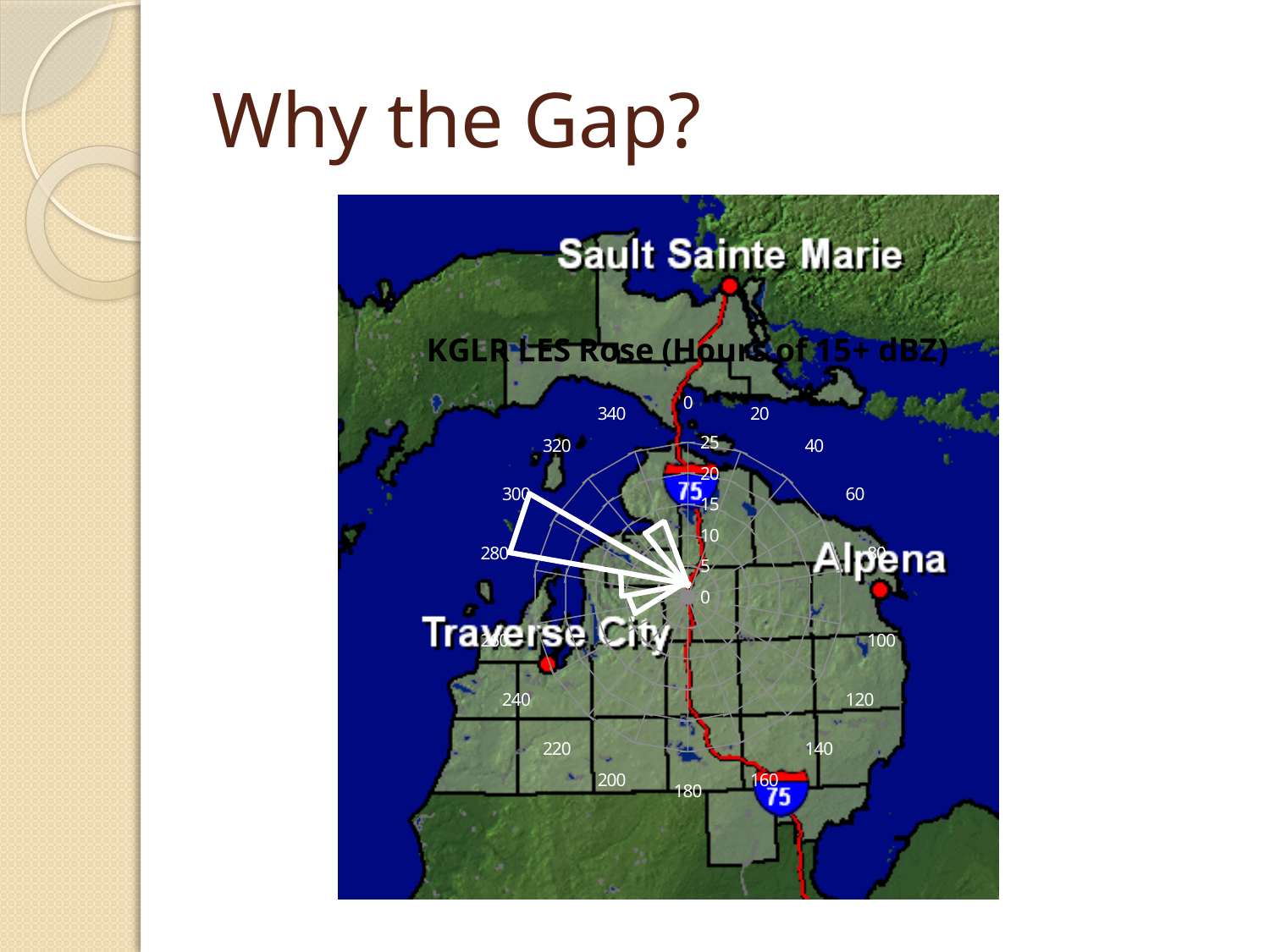
What kind of chart is shown on the slide? radar chart What is the largest value labelled on the radial axis of the chart? 25 Is the value in the 100 direction greater or less than 5? less Is the value in the 40 direction greater or less than 5? less Is the value in the 300 direction greater or less than 15? greater How many direction labels are shown around the outside of the chart? 18 What is the title of the chart? KGLR LES Rose (Hours of 15+ dBZ) Which direction label has the highest value on the chart? 300